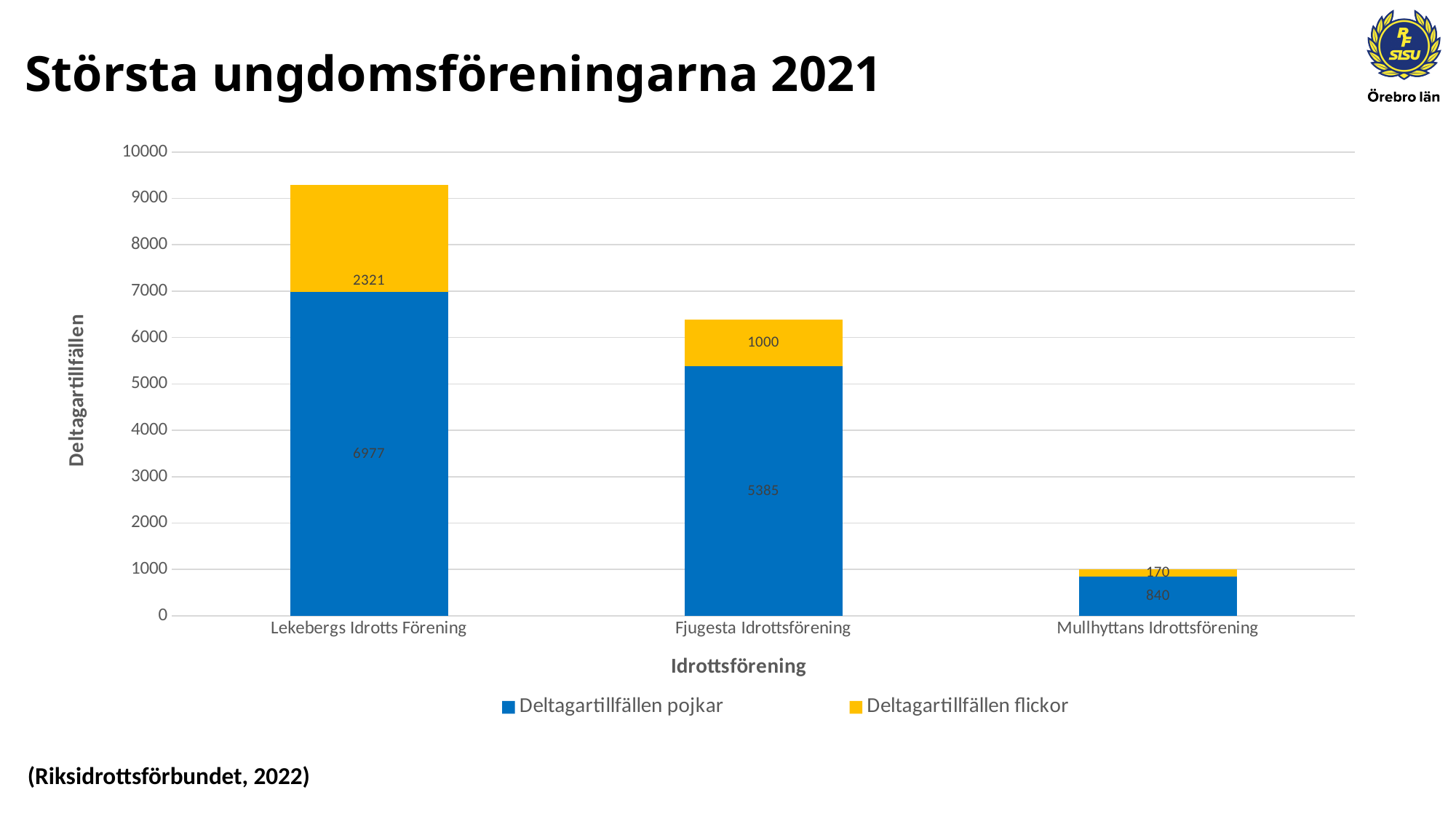
What is the value of Deltagartillfällen flickor for Mullhyttans Idrottsförening? 170 Which is larger: Deltagartillfällen flickor for Lekebergs Idrotts Förening or for Fjugesta Idrottsförening? Lekebergs Idrotts Förening How many series does the legend list? 2 What is the value of Deltagartillfällen flickor for Fjugesta Idrottsförening? 1000 What is the value of Deltagartillfällen pojkar for Lekebergs Idrotts Förening? 6977 What is the difference between Deltagartillfällen pojkar for Lekebergs Idrotts Förening and Fjugesta Idrottsförening? 1592 How many clubs are shown on the x axis? 3 What is the total of the stacked bar for Mullhyttans Idrottsförening? 1010 What kind of chart is shown on the slide? Stacked bar chart Which club has the highest value for Deltagartillfällen pojkar? Lekebergs Idrotts Förening What is the total of the stacked bar for Fjugesta Idrottsförening? 6385 Which club has the lowest value for Deltagartillfällen flickor? Mullhyttans Idrottsförening